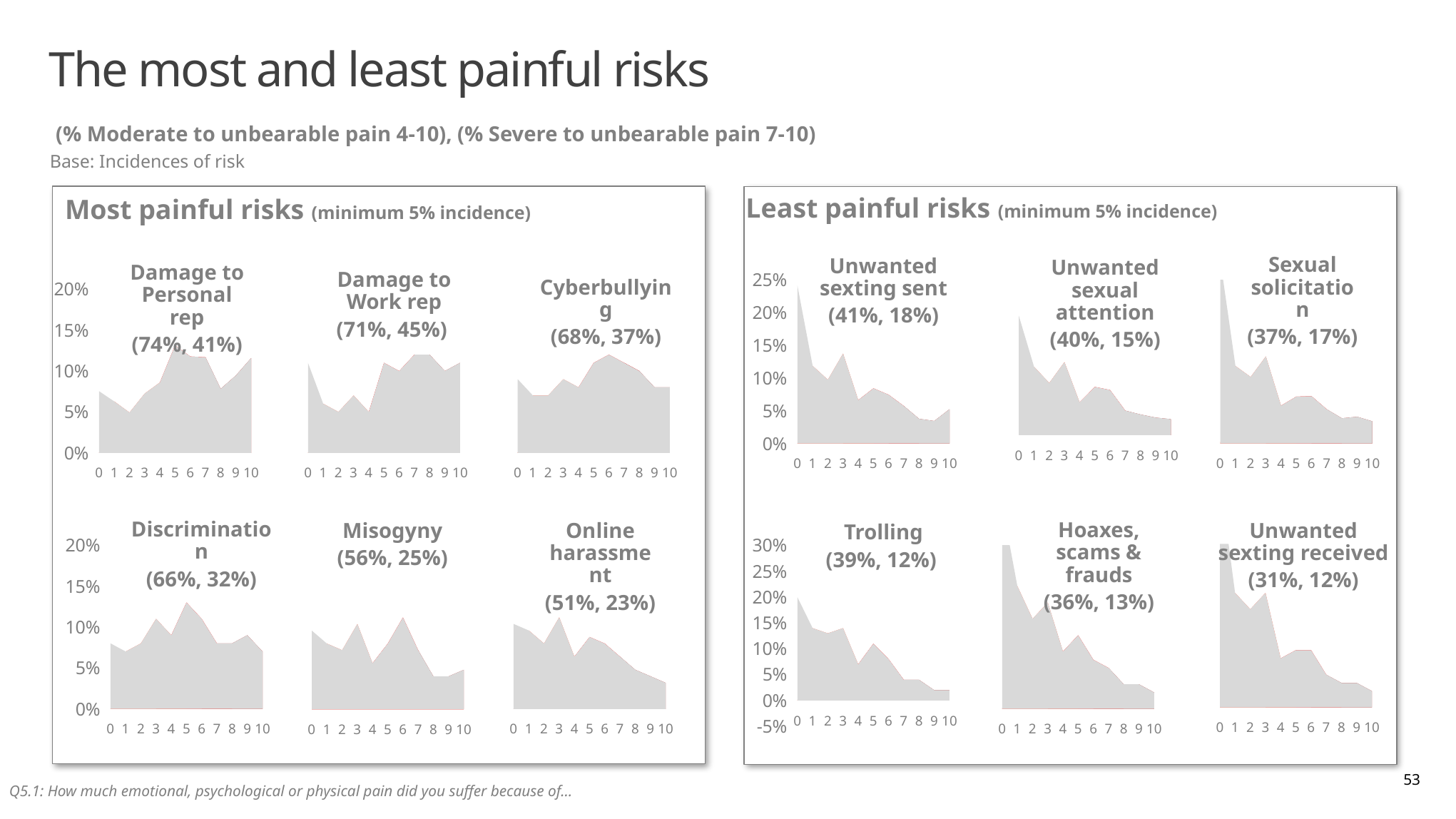
In the 'Sexual solicitation' chart, is the value at x = 0 greater or less than 20%? greater How many small charts are shown in the Most painful risks panel? 6 In the 'Hoaxes, scams & frauds' chart, is the value at x = 0 greater or less than 25%? greater What two percentages are printed in the title of the 'Trolling' chart? (39%, 12%) In the 'Damage to Personal rep' chart, is the value at x = 5 greater or less than 10%? greater What kind of chart is used for 'Damage to Personal rep' in the Most painful risks panel? area chart In the 'Unwanted sexting received' chart, do the values generally rise or fall from x = 0 to x = 10? fall In the 'Hoaxes, scams & frauds' chart, which is larger: the value at x = 0 or the value at x = 10? x = 0 How many points along the x axis (0 to 10) does the 'Trolling' chart plot? 11 What two percentages are printed in the title of the 'Cyberbullying' chart? (68%, 37%)